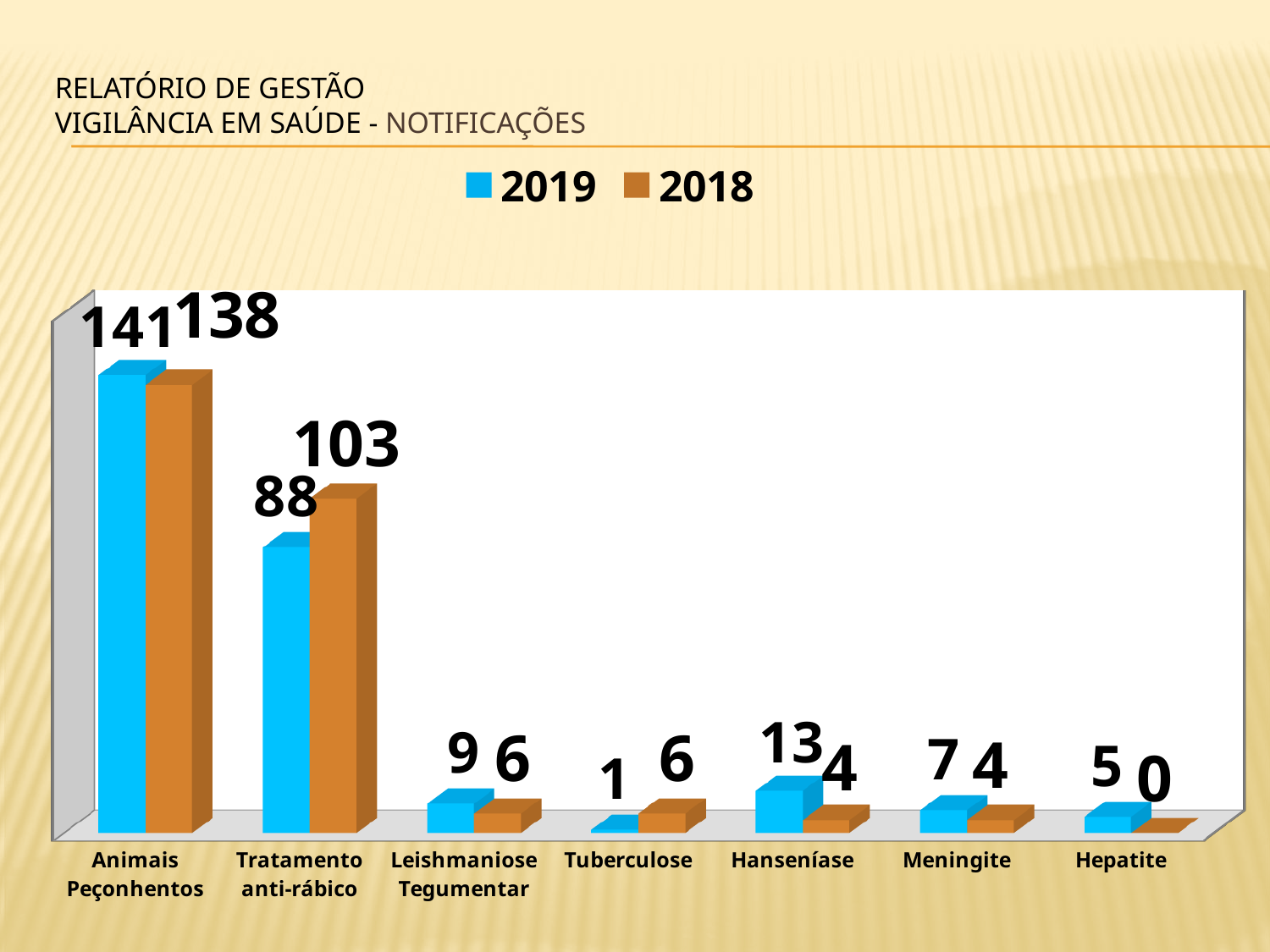
What kind of chart is shown on the slide? Bar chart Which is larger for Tuberculose, the 2019 value or the 2018 value? 2018 Which category has the lowest 2018 value? Hepatite What is the 2018 value for Tratamento anti-rábico? 103 What is the difference between the 2018 and 2019 values for Tratamento anti-rábico? 15 Which colour represents the 2019 series in the legend? Blue What is the 2019 value for Animais Peçonhentos? 141 What is the 2018 value for Hepatite? 0 What is the 2019 value for Hanseníase? 13 Which category has the highest 2019 value? Animais Peçonhentos How many series does the legend list? 2 How many categories are shown on the x axis? 7